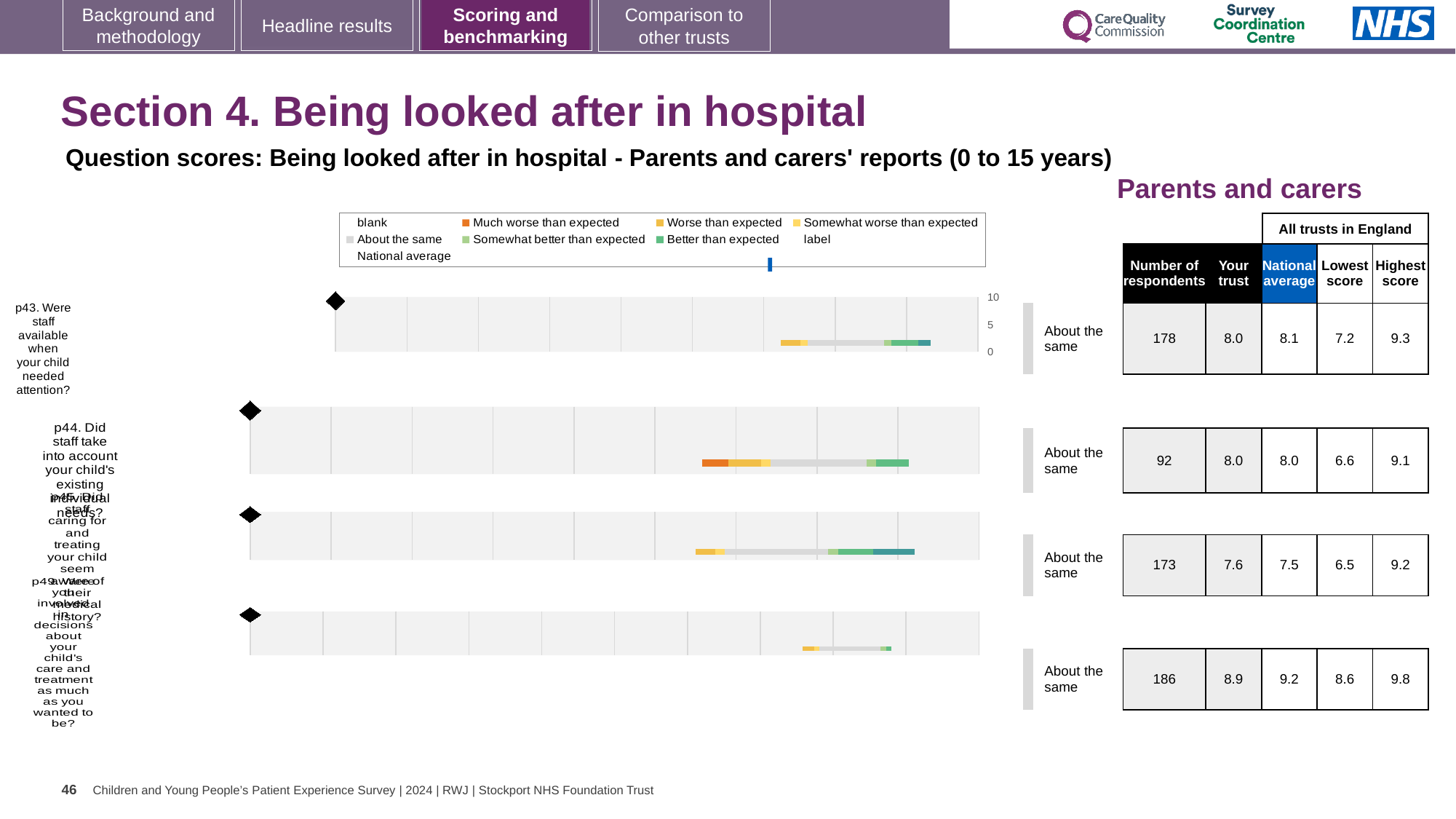
Which question row has the highest 'Your trust' score? the fourth (bottom) row, 8.9 What benchmark category is shown next to the p43 chart? About the same For p44 (Did staff take into account your child's existing individual needs?), how many respondents are there? 92 Which question row has the lowest 'Lowest score' value? the third row, 6.5 For the third question row, which is larger: the 'Your trust' score or the national average? Your trust (7.6 vs 7.5) For p43 (Were staff available when your child needed attention?), what is the national average score? 8.1 In the legend, what colour represents 'Much worse than expected'? orange For p43, what is the difference between the highest score (9.3) and the lowest score (7.2)? 2.1 How many question charts (rows) are shown on the slide? 4 For p43 (Were staff available when your child needed attention?), what is the 'Your trust' score? 8.0 What type of chart is used to show the question scores on this slide? bar chart For the fourth (bottom) question chart, what is the highest score among all trusts in England? 9.8